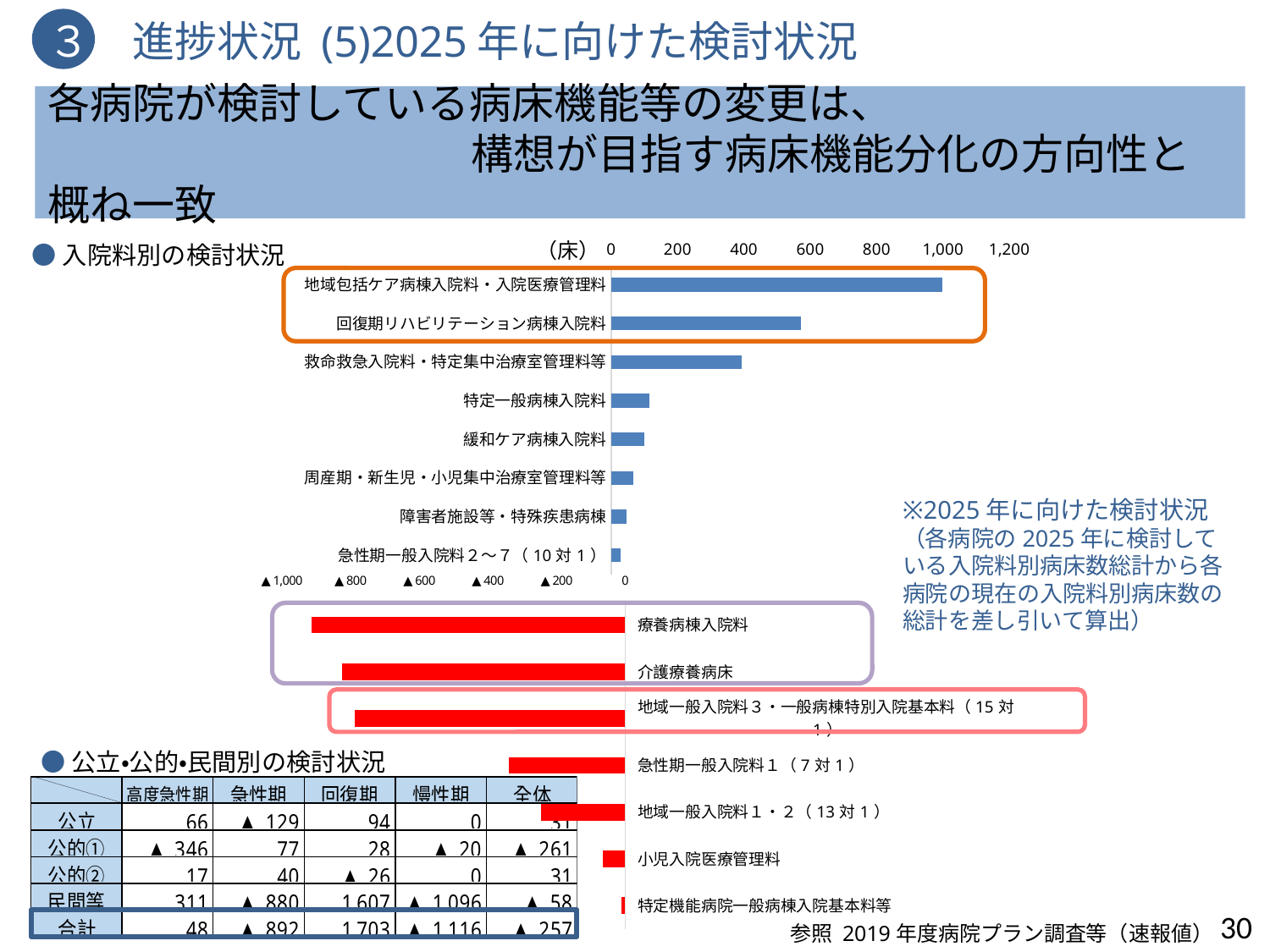
What kind of chart is the upper blue chart under 入院料別の検討状況? bar chart In the upper blue chart, which is larger, 救命救急入院料・特定集中治療室管理料等 or 緩和ケア病棟入院料? 救命救急入院料・特定集中治療室管理料等 In the upper blue chart, do the bar lengths increase or decrease going from the top category to the bottom category? decrease In the upper blue chart, which category has the longest bar? 地域包括ケア病棟入院料・入院医療管理料 In the upper blue chart, which category has the shortest bar? 急性期一般入院料２～７（10対1） In the upper blue chart, how many categories are plotted? 8 In the upper blue chart, is the value for 回復期リハビリテーション病棟入院料 greater or less than 400? greater In the lower red chart, which category has the shortest bar? 特定機能病院一般病棟入院基本料等 In the lower red chart, is the value for 急性期一般入院料１（7対1） a decrease greater or less than 200 beds? greater In the lower red chart, which category has the longest bar (largest decrease)? 療養病棟入院料 In the upper blue chart, is the value for 特定一般病棟入院料 greater or less than 200? less What is the highest tick label shown on the axis of the upper blue chart? 1,200